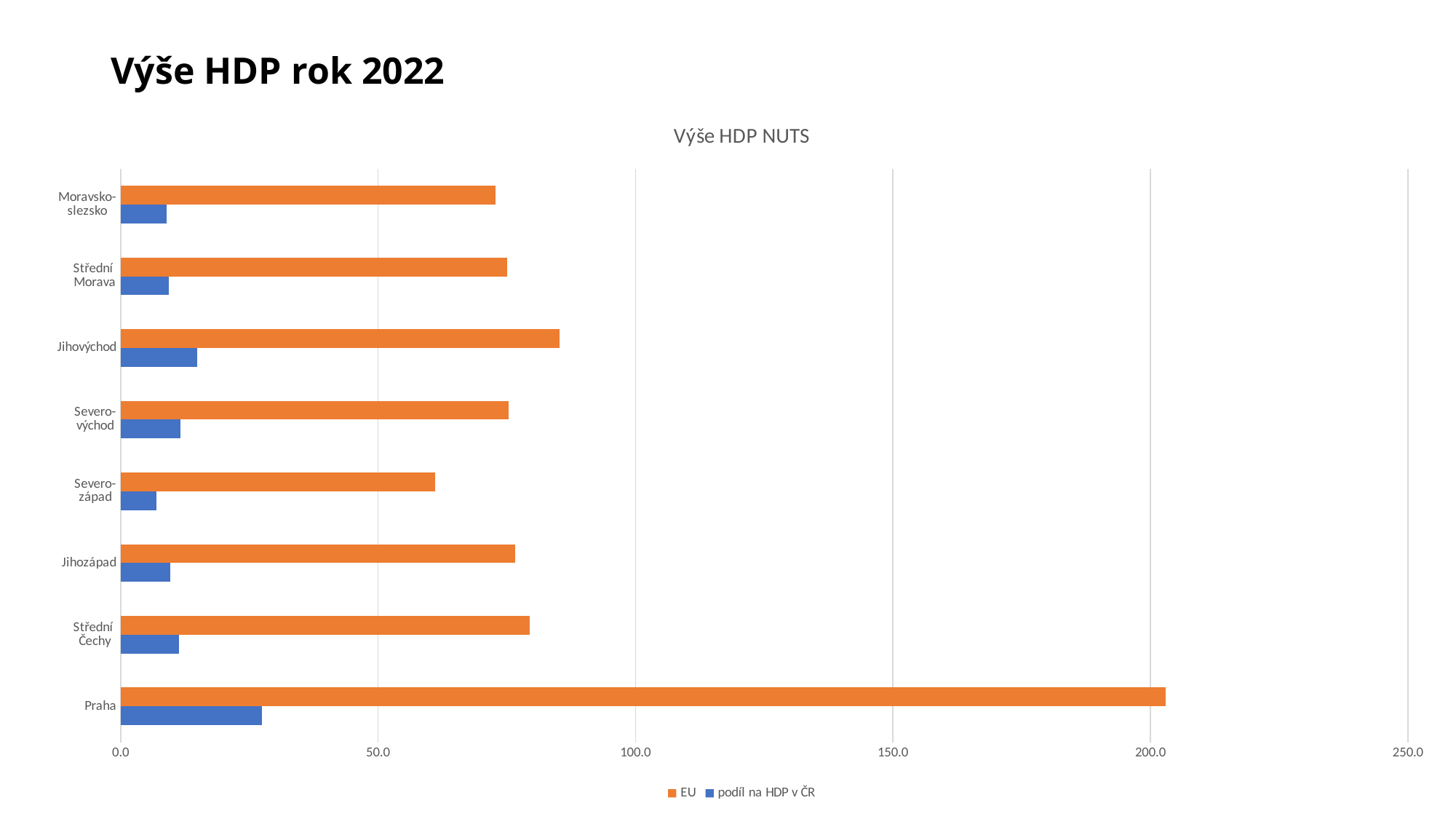
Which has the larger EU value, Jihovýchod or Střední Čechy? Jihovýchod Is the EU value for Jihovýchod greater or less than 100? less What is the title of the chart? Výše HDP NUTS What kind of chart is shown on the slide? bar chart Which series is shown in orange? EU Which region has the highest value for 'podíl na HDP v ČR'? Praha How many regions (categories) are plotted on the chart? 8 Is the 'podíl na HDP v ČR' value for Praha greater or less than 50? less Which region has the lowest EU value? Severozápad Which region has the highest EU value? Praha How many series does the legend list? 2 Is the EU value for Praha greater or less than 150? greater